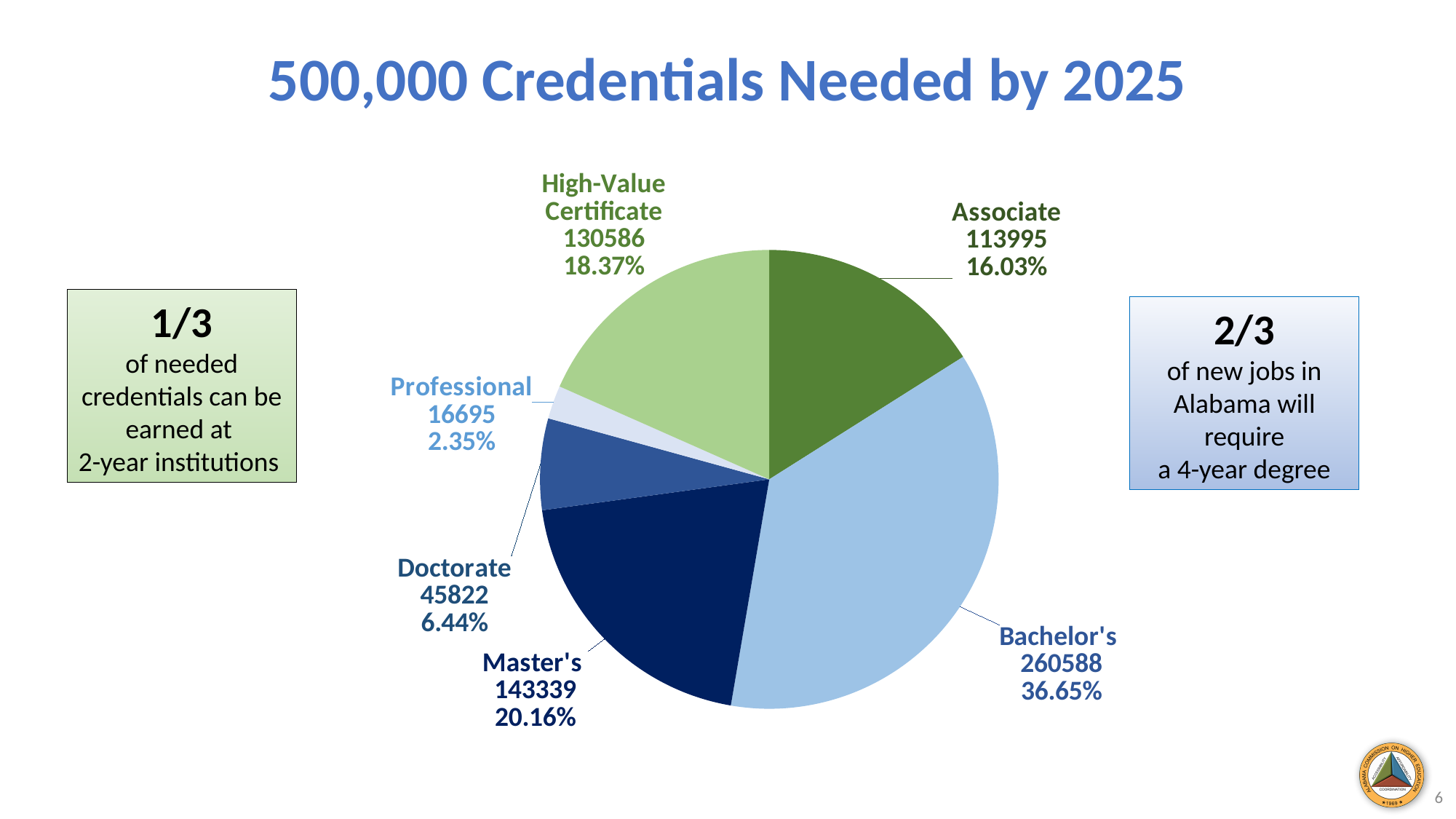
What is the number of credentials needed for Bachelor's? 260588 How many credential categories does the pie chart show? 6 What is the title of the slide containing the pie chart? 500,000 Credentials Needed by 2025 Which category has the smallest slice of the pie? Professional What is the value shown for Doctorate? 45822 What type of chart is shown on the slide? pie chart What is the difference between the Bachelor's value and the Associate value? 146593 What percentage share does the High-Value Certificate slice represent? 18.37% What percentage share is shown for Professional? 2.35% What is the difference between the Master's value and the Doctorate value? 97517 Which is larger, the Associate value or the High-Value Certificate value? High-Value Certificate Which category has the largest slice of the pie? Bachelor's